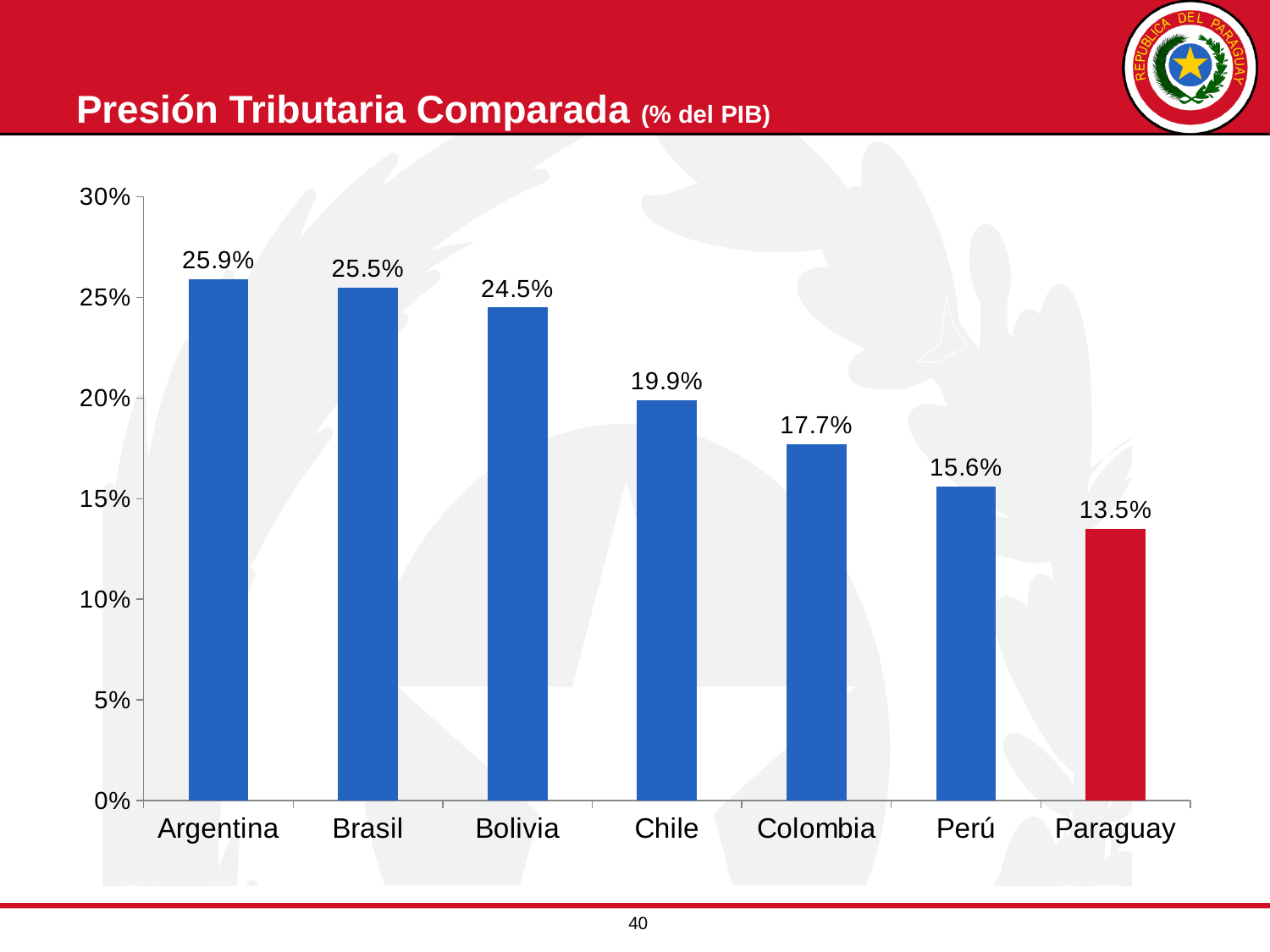
What is the value for Chile? 19.9% What is the difference between the values for Colombia and Perú? 2.1% Is the value for Perú greater or less than 20%? less How many countries are shown in the chart? 7 What kind of chart is shown on the slide? bar chart What is the difference between the values for Argentina and Paraguay? 12.4% Which is larger, the value for Bolivia or the value for Chile? Bolivia Which country's bar is coloured red instead of blue? Paraguay What is the value for Argentina? 25.9% Which country has the highest value? Argentina Which country has the lowest value? Paraguay What is the value for Paraguay? 13.5%